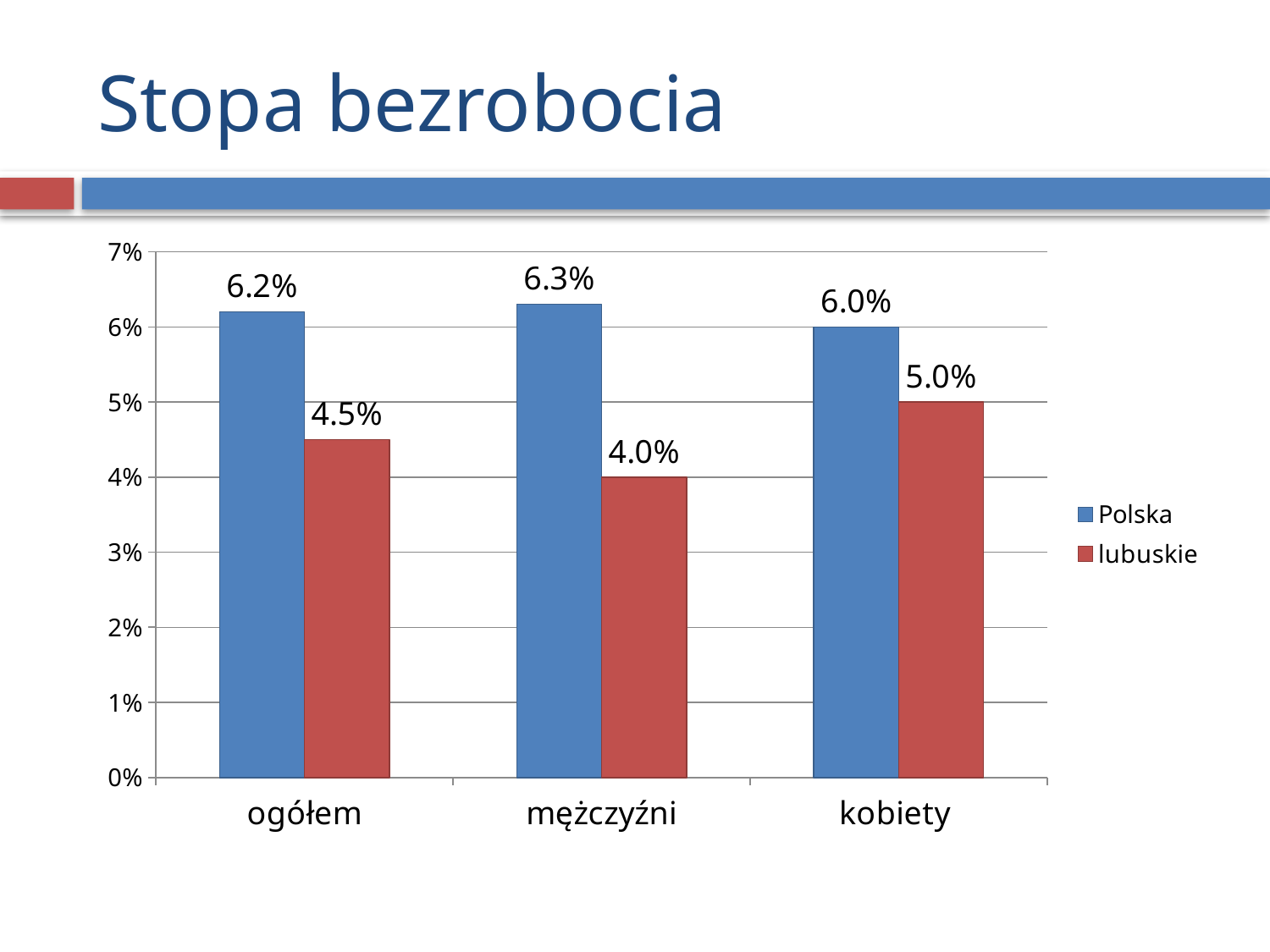
How many categories are shown on the x axis? 3 Which is larger in the kobiety category, Polska or lubuskie? Polska What is the difference between the Polska and lubuskie values in the mężczyźni category? 2.3% What is the value for lubuskie in the kobiety category? 5.0% Is the value for lubuskie in the ogółem category greater or less than 5%? less Which category has the highest value for Polska? mężczyźni What is the value for Polska in the ogółem category? 6.2% How many series does the legend list? 2 What kind of chart is shown on the slide? bar chart What is the value for lubuskie in the mężczyźni category? 4.0% Which category has the lowest value for lubuskie? mężczyźni What colour are the bars for the lubuskie series? red